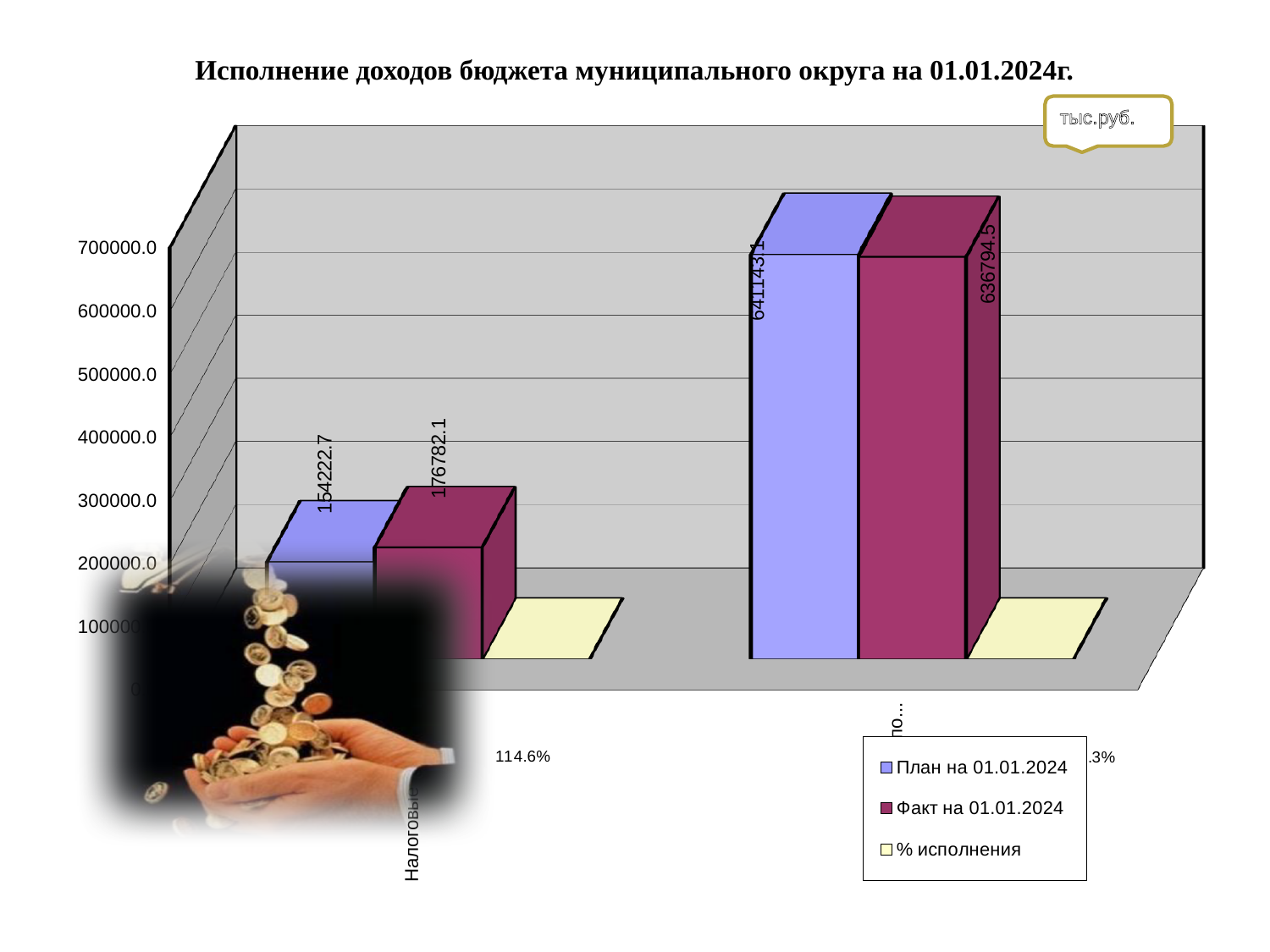
What is the value of 'Факт на 01.01.2024' for the right-hand category? 636794.5 Is the 'Факт на 01.01.2024' value for the right-hand category greater or less than 600000.0? greater How many series does the legend list? 3 What is the value of 'План на 01.01.2024' for the 'Налоговые' category? 154222.7 For the 'Налоговые' category, which is larger: 'План на 01.01.2024' or 'Факт на 01.01.2024'? Факт на 01.01.2024 Is the 'План на 01.01.2024' value for the 'Налоговые' category greater or less than 200000.0? less By how much does 'Факт на 01.01.2024' exceed 'План на 01.01.2024' for the 'Налоговые' category? 22559.4 What is the value of 'Факт на 01.01.2024' for the 'Налоговые' category? 176782.1 What is the title of the chart? Исполнение доходов бюджета муниципального округа на 01.01.2024г. What is the '% исполнения' value shown for the 'Налоговые' category? 114.6% What kind of chart is shown on the slide? bar chart What is the value of 'План на 01.01.2024' for the right-hand category? 641143.1